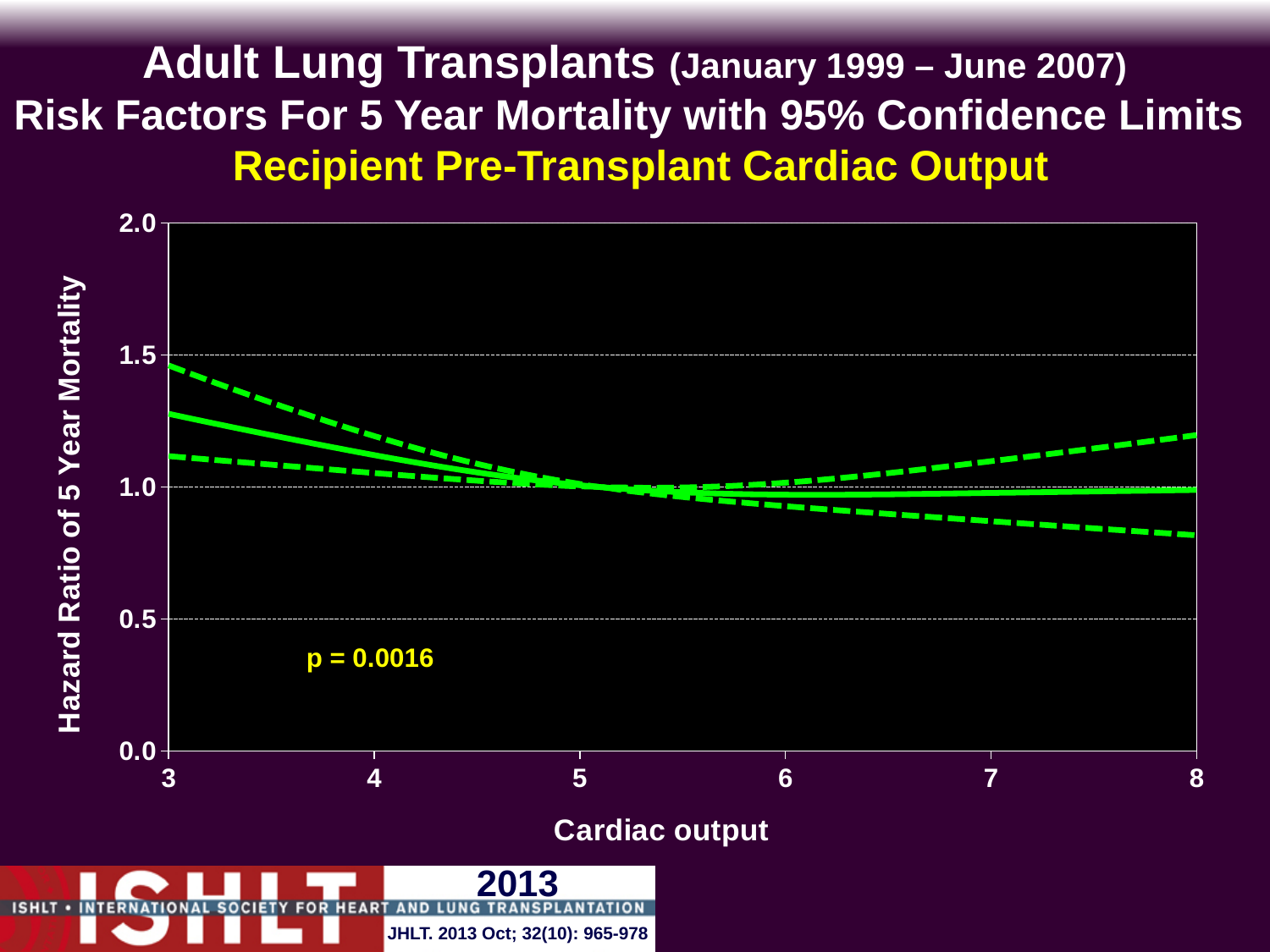
Does the solid hazard ratio line rise or fall as cardiac output increases from 3 to 8? fall Is the hazard ratio (solid line) at a cardiac output of 3 greater or less than 1.0? greater What kind of chart is shown on the slide? line chart Is the upper confidence limit (upper dashed line) at a cardiac output of 8 greater or less than 1.0? greater Is the lower confidence limit (lower dashed line) at a cardiac output of 8 greater or less than 1.0? less How many tick values are labelled on the x axis? 6 Is the hazard ratio (solid line) higher at a cardiac output of 3 or at a cardiac output of 8? 3 What p-value is printed on the chart? p = 0.0016 How many lines are plotted on the chart? 3 What is the label of the x axis? Cardiac output